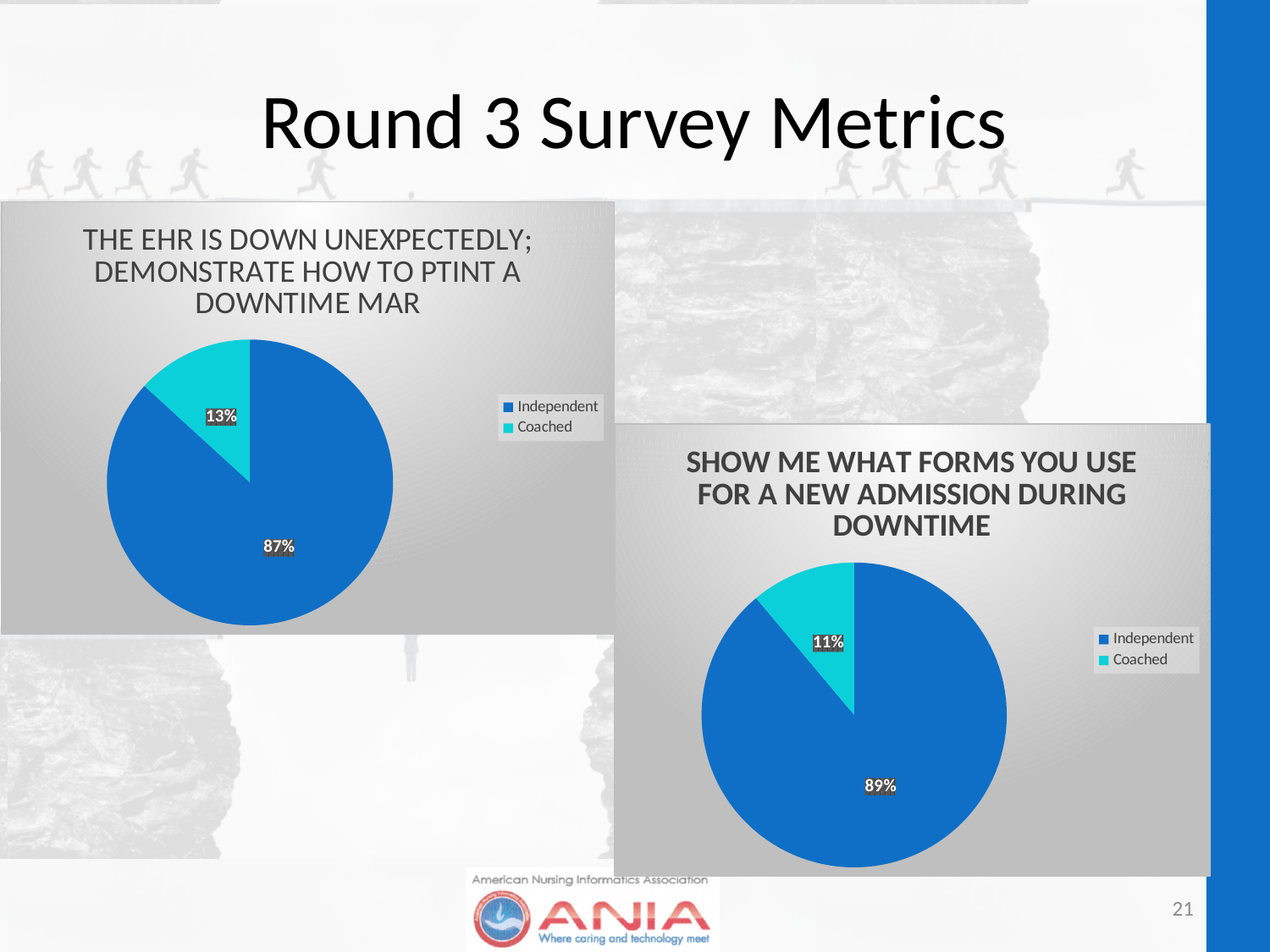
In the right pie chart about forms for a new admission during downtime, what percentage is shown for Coached? 11% In the left pie chart about printing a downtime MAR, what colour is the Coached slice? Light blue (cyan) How many categories does the legend list in the right pie chart about forms for a new admission during downtime? 2 Which chart has the larger Independent share: the left chart about printing a downtime MAR or the right chart about forms for a new admission? The right chart about forms for a new admission What type of chart is used on the left for the downtime MAR question? Pie chart In the right pie chart titled 'Show me what forms you use for a new admission during downtime', what percentage is shown for Independent? 89% In the left pie chart titled 'The EHR is down unexpectedly; demonstrate how to ptint a downtime MAR', what percentage is shown for Independent? 87% In the left pie chart about printing a downtime MAR, which category has the largest slice? Independent In the right pie chart about forms for a new admission during downtime, what is the difference between the Independent and Coached percentages? 78% In the left pie chart about printing a downtime MAR, what percentage is shown for Coached? 13% In the right pie chart about forms for a new admission during downtime, which category has the smallest slice? Coached In the left pie chart about printing a downtime MAR, what is the difference between the Independent and Coached percentages? 74%